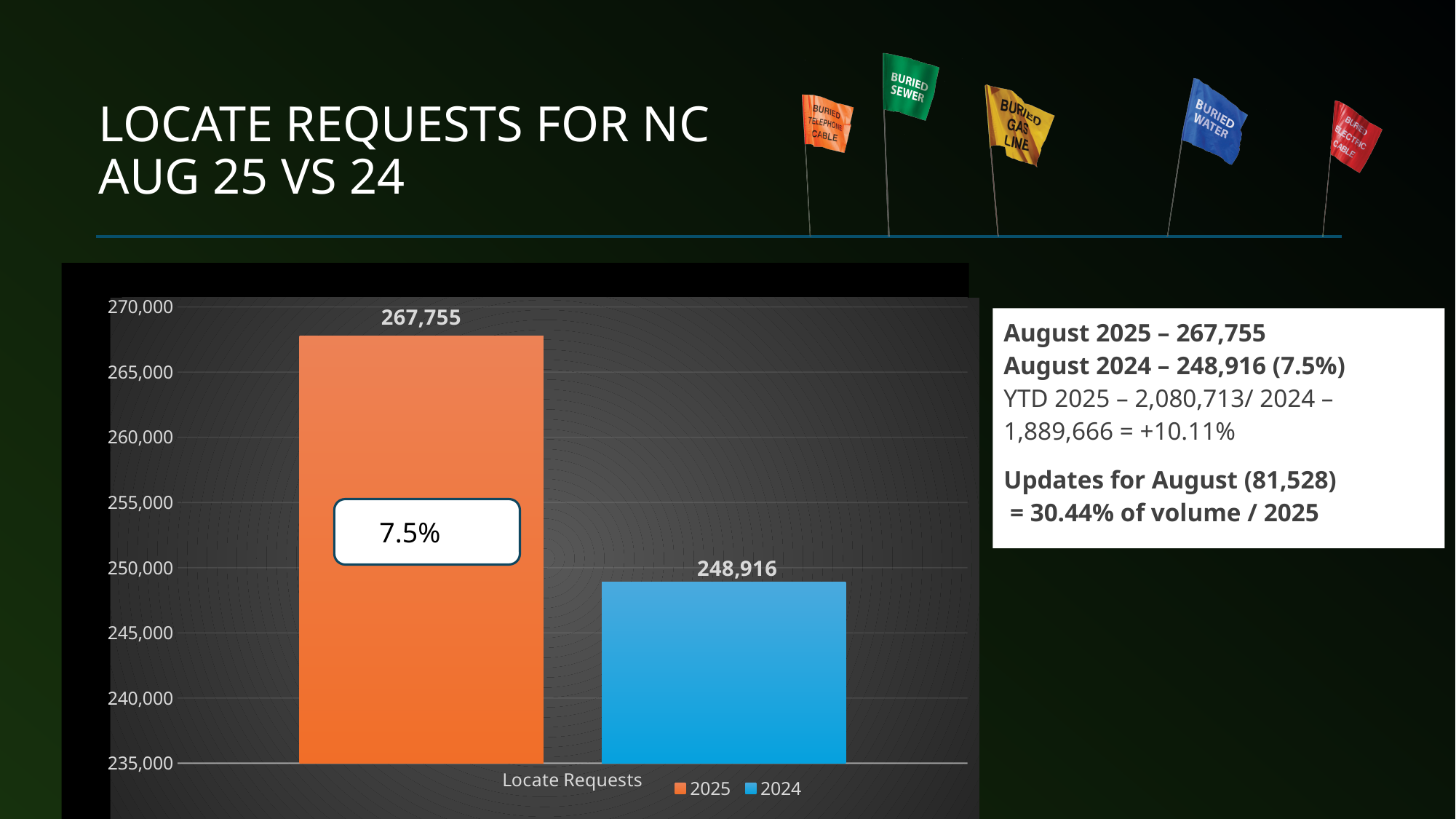
What is the value of the 2025 bar for Locate Requests? 267,755 What is the difference between the 2025 and 2024 Locate Requests values? 18,839 How many series does the legend list? 2 Which series has the higher value for Locate Requests, 2025 or 2024? 2025 What is the value of the 2024 bar for Locate Requests? 248,916 What percentage is shown in the callout box on the 2025 bar? 7.5% What is the category label on the x axis of the chart? Locate Requests Is the value for 2025 greater or less than 265,000? greater What kind of chart is shown on the slide? bar chart Is the value for 2024 greater or less than 250,000? less What colour is the 2024 bar? blue Which series has the lowest value on the chart? 2024